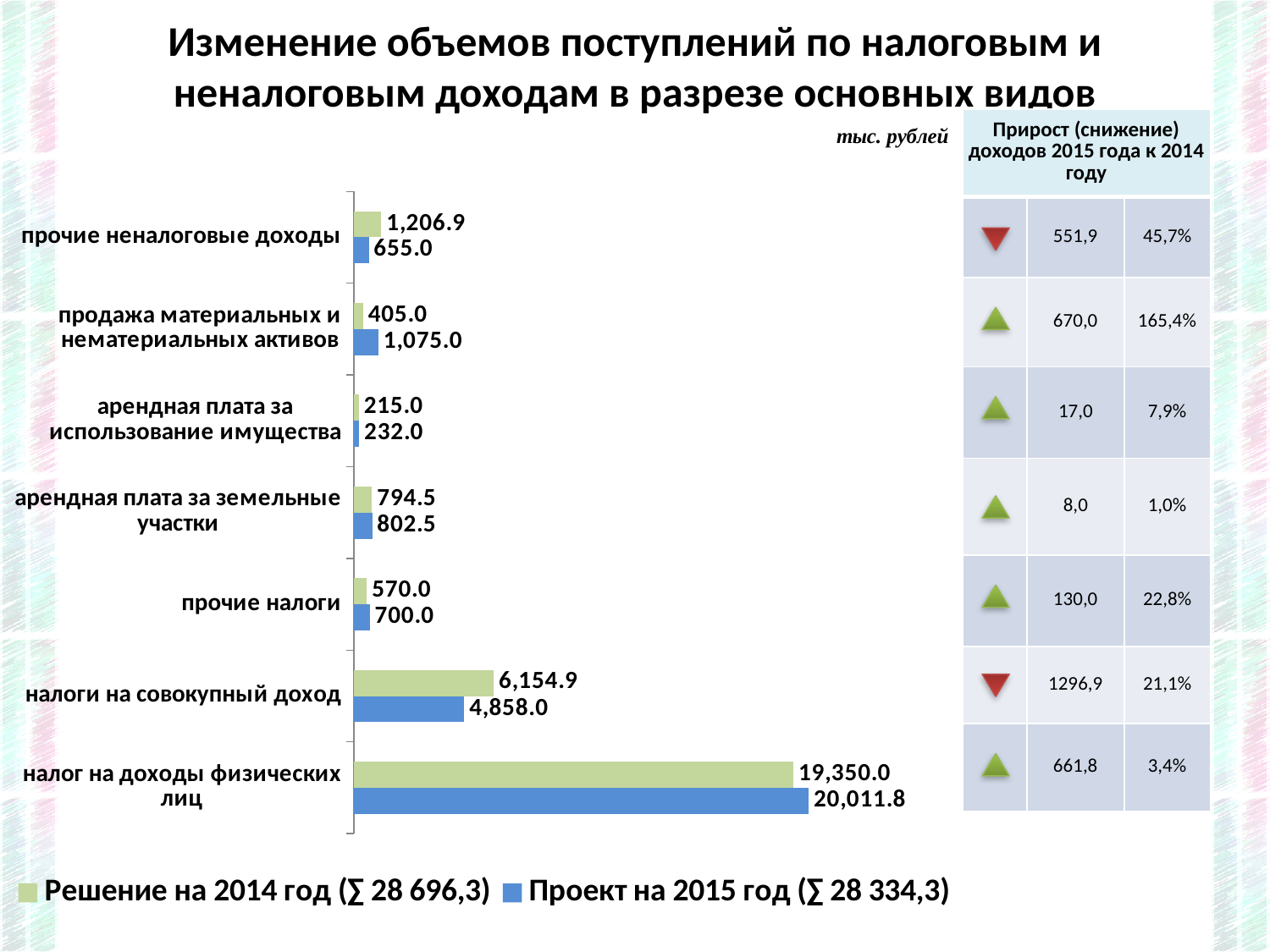
What is the difference between the 2015 and 2014 values for 'налог на доходы физических лиц'? 661.8 For 'прочие неналоговые доходы', which series has the larger value: 'Решение на 2014 год' or 'Проект на 2015 год'? Решение на 2014 год How many series does the chart legend list? 2 Which category has the lowest value in the series 'Решение на 2014 год'? арендная плата за использование имущества What is the difference between the 2014 and 2015 values for 'налоги на совокупный доход'? 1,296.9 How many categories are plotted on the chart? 7 What is the value for 'продажа материальных и нематериальных активов' in the series 'Проект на 2015 год'? 1,075.0 Which category has the highest value in the series 'Решение на 2014 год'? налог на доходы физических лиц What is the value for 'налоги на совокупный доход' in the series 'Решение на 2014 год'? 6,154.9 What unit of measurement is indicated above the chart? тыс. рублей What is the value for 'налог на доходы физических лиц' in the series 'Проект на 2015 год'? 20,011.8 What kind of chart is shown on the slide? bar chart